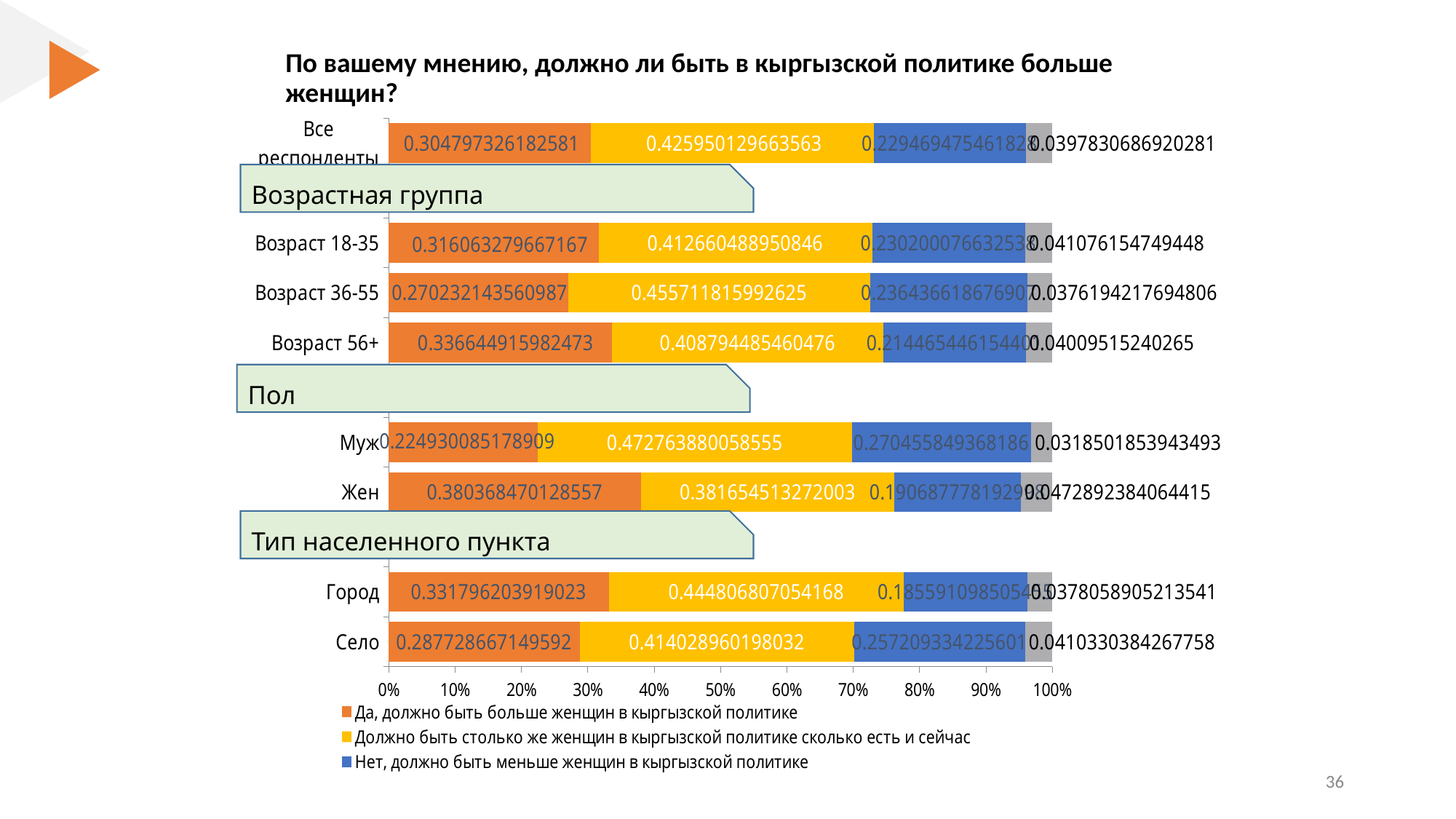
Is the value of "Да, должно быть больше женщин в кыргызской политике" for Возраст 56+ greater or less than 30%? greater Which has the larger value for "Да, должно быть больше женщин в кыргызской политике": Город or Село? Город Which category has the lowest value for "Да, должно быть больше женщин в кыргызской политике"? Муж What is the title of the chart? По вашему мнению, должно ли быть в кыргызской политике больше женщин? Which category has the highest value for "Да, должно быть больше женщин в кыргызской политике"? Жен What is the value of "Да, должно быть больше женщин в кыргызской политике" for Жен? 0.380368470128557 What kind of chart is shown on the slide? bar chart How many respondent categories (bars) are plotted in the chart? 8 How many series does the legend list? 3 Which category has the highest value for "Должно быть столько же женщин в кыргызской политике сколько есть и сейчас"? Муж What is the value of "Должно быть столько же женщин в кыргызской политике сколько есть и сейчас" for Возраст 36-55? 0.455711815992625 What is the value of "Должно быть столько же женщин в кыргызской политике сколько есть и сейчас" for Муж? 0.472763880058555